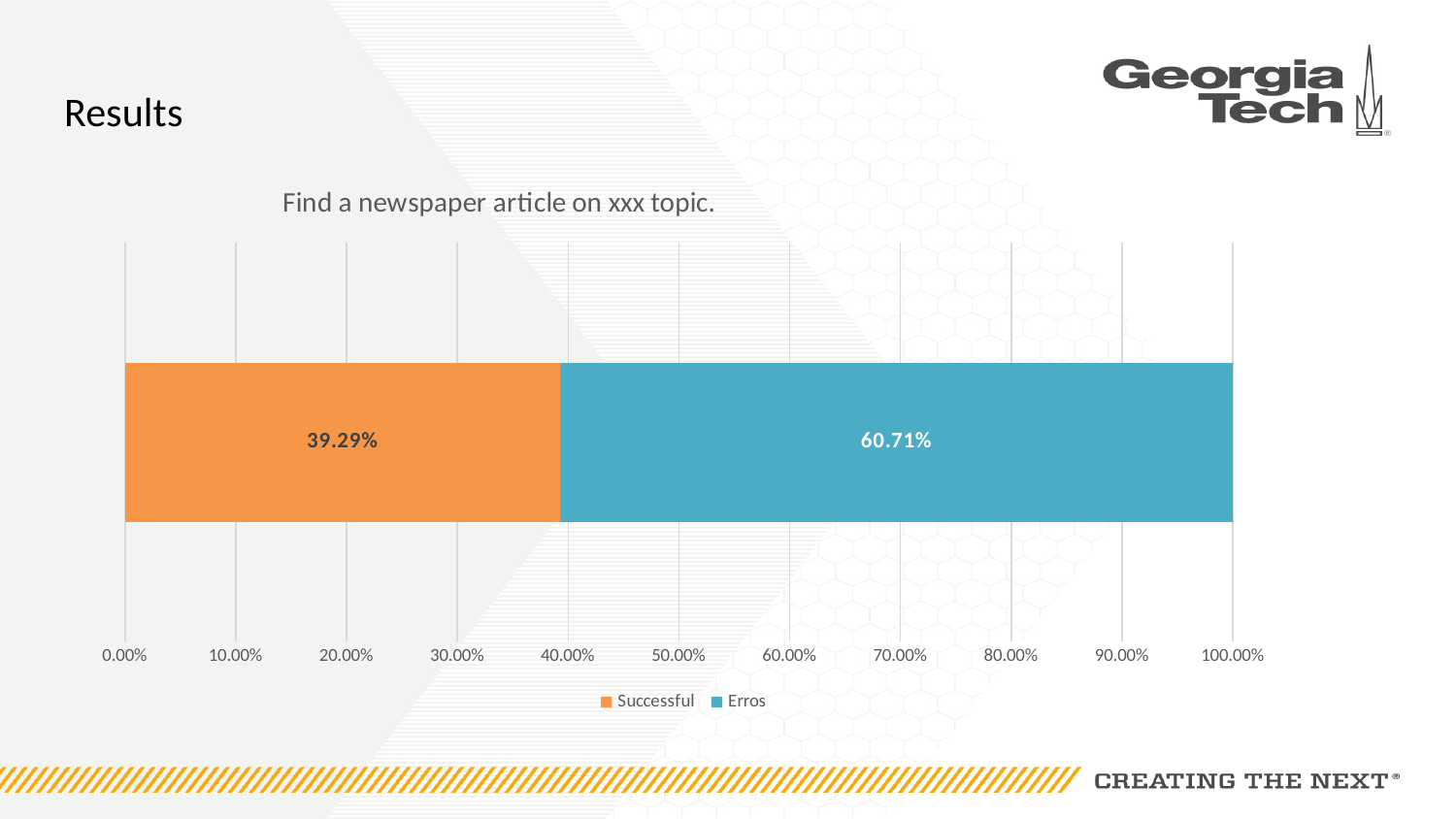
How many series does the legend list? 2 What is the highest value shown on the x axis? 100.00% What is the value for Erros? 60.71% What kind of chart is shown? Stacked bar chart Is the value for Erros greater or less than 50.00%? greater Which series has the larger value, Successful or Erros? Erros What is the value for Successful? 39.29% What is the difference between the Erros value and the Successful value? 21.42% Is the value for Successful greater or less than 40.00%? less What colour represents the Successful series? Orange What is the title of the chart? Find a newspaper article on xxx topic. What is the total of the stacked bar? 100.00%